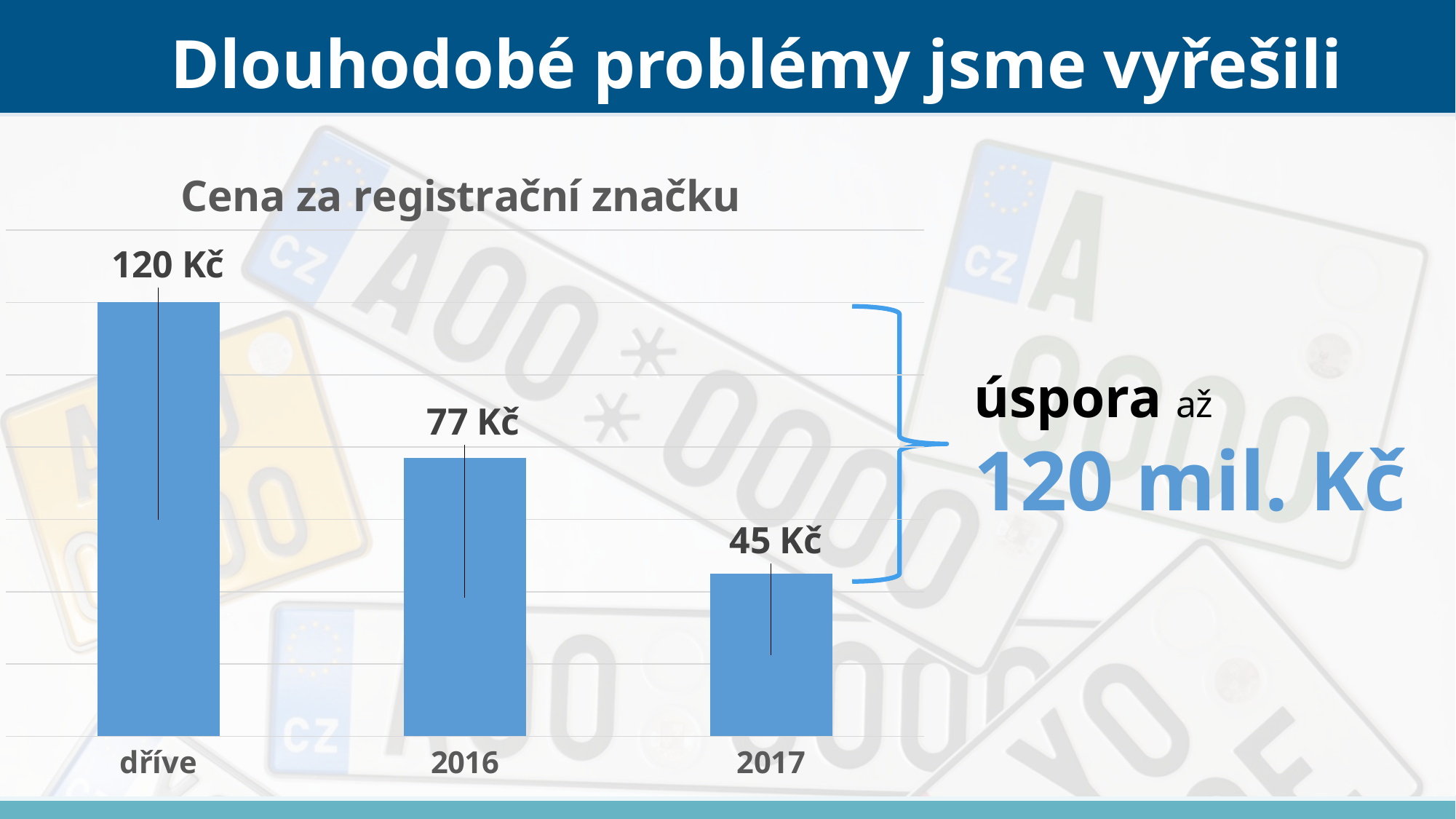
What is the price shown for 2017? 45 Kč Do the values rise or fall from left to right along the x axis? fall What is the difference between the price in 2016 and the price in 2017? 32 Kč What kind of chart is shown on the slide? bar chart What is the price for the 'dříve' category in the chart 'Cena za registrační značku'? 120 Kč Which is larger, the price in 2016 or the price in 2017? 2016 Which category has the highest price? dříve What is the price shown for 2016? 77 Kč How many categories are shown on the x axis of the chart? 3 What is the difference between the price 'dříve' and the price in 2017? 75 Kč Which category has the lowest price? 2017 What is the title of the chart? Cena za registrační značku